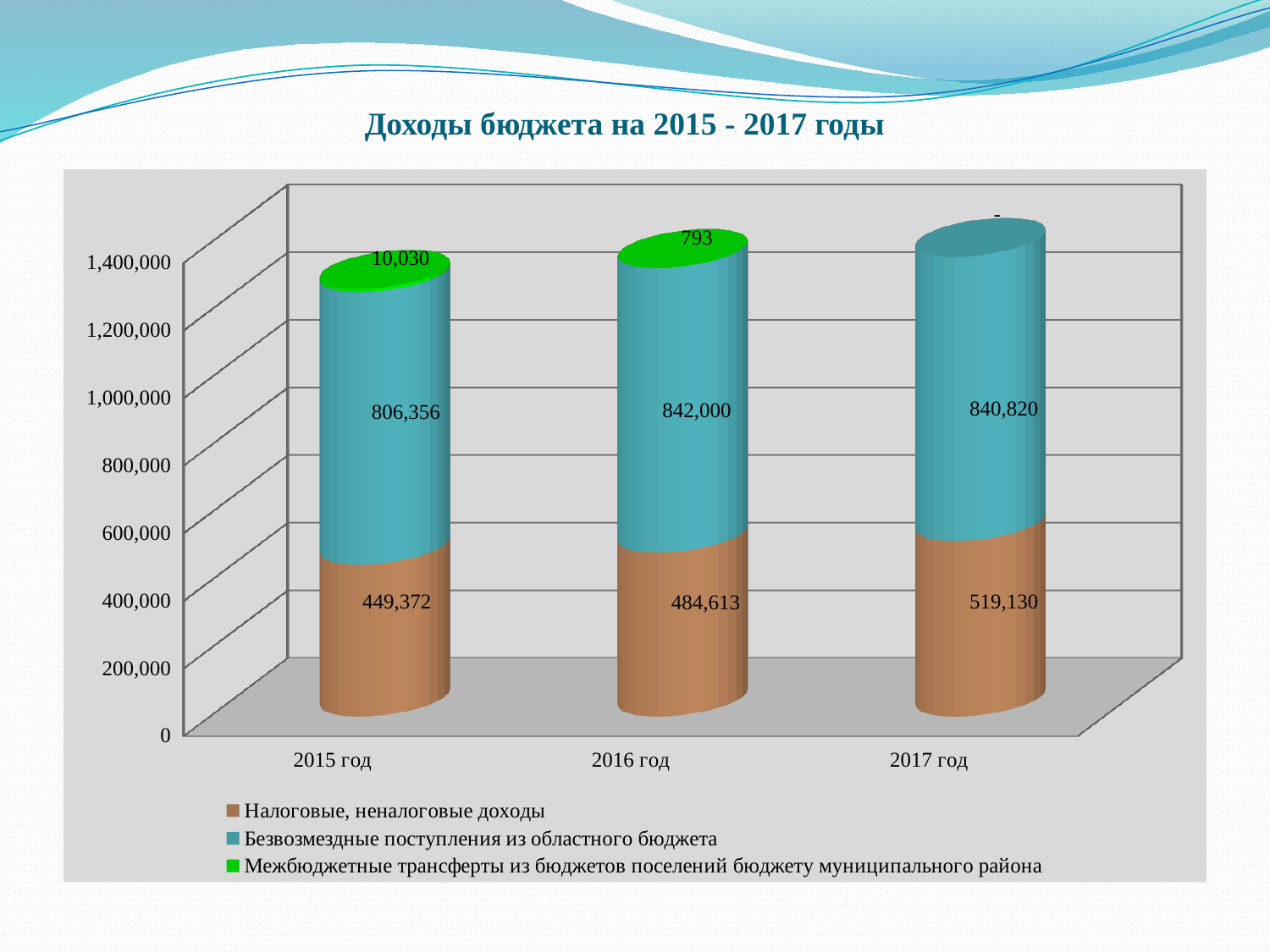
What is the value of Межбюджетные трансферты из бюджетов поселений бюджету муниципального района for 2015 год? 10,030 What is the value of Безвозмездные поступления из областного бюджета for 2016 год? 842,000 What is the difference between Налоговые, неналоговые доходы in 2017 год and in 2015 год? 69,758 How many years (categories) are shown on the x axis? 3 How many series does the legend list? 3 In which year is Налоговые, неналоговые доходы the highest? 2017 год What type of chart is shown on the slide? Bar chart What is the difference between Безвозмездные поступления из областного бюджета in 2016 год and in 2015 год? 35,644 Does Налоговые, неналоговые доходы rise or fall from 2015 год to 2017 год? Rise Which is larger: Налоговые, неналоговые доходы in 2016 год or in 2017 год? 2017 год What is the value of Налоговые, неналоговые доходы for 2015 год? 449,372 What is the total of the stacked bar for 2016 год? 1,327,406